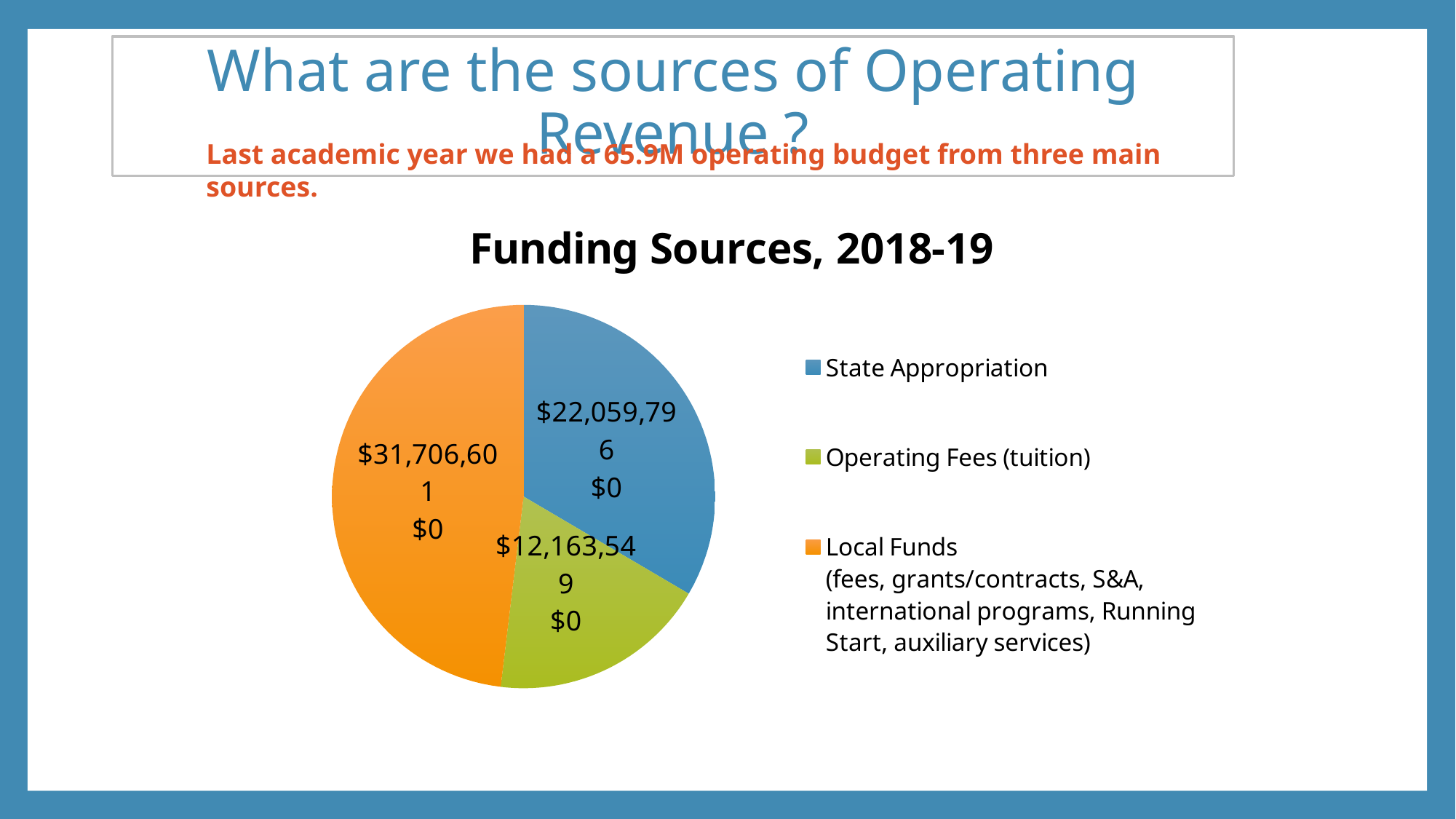
Which funding source has the smallest slice of the pie? Operating Fees (tuition) What is the title of the chart? Funding Sources, 2018-19 What is the value shown for Local Funds? $31,706,601 What is the difference between State Appropriation and Operating Fees (tuition)? $9,896,247 Which is larger, State Appropriation or Operating Fees (tuition)? State Appropriation What is the difference between Local Funds and State Appropriation? $9,646,805 How many funding sources are shown in the pie chart? 3 What is the value shown for Operating Fees (tuition)? $12,163,549 What type of chart is shown on the slide? pie chart Which funding source has the largest slice of the pie? Local Funds What colour is the Local Funds slice? orange What is the value shown for State Appropriation? $22,059,796